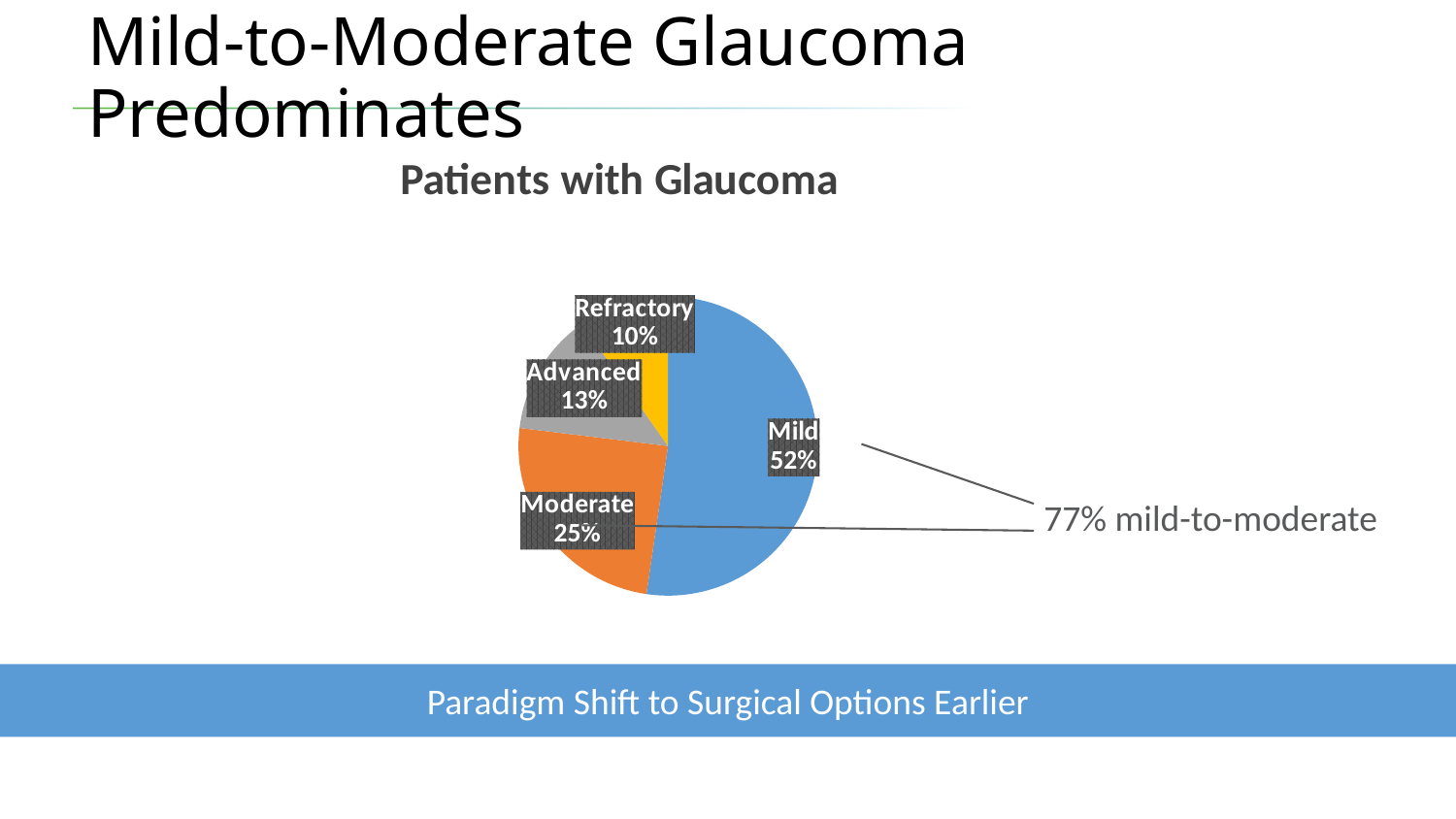
Which is larger, the Advanced slice or the Refractory slice? Advanced What is the combined share of the Mild and Moderate slices? 77% How many categories are shown in the pie chart? 4 What is the difference in percentage points between the Mild and Moderate slices? 27 What percentage of patients have Moderate glaucoma? 25% What is the title of the chart? Patients with Glaucoma What percentage of patients have Mild glaucoma? 52% What percentage of patients have Refractory glaucoma? 10% Which category has the smallest share of the pie? Refractory Which category has the largest share of the pie? Mild What percentage of patients have Advanced glaucoma? 13% What kind of chart is shown on the slide? pie chart